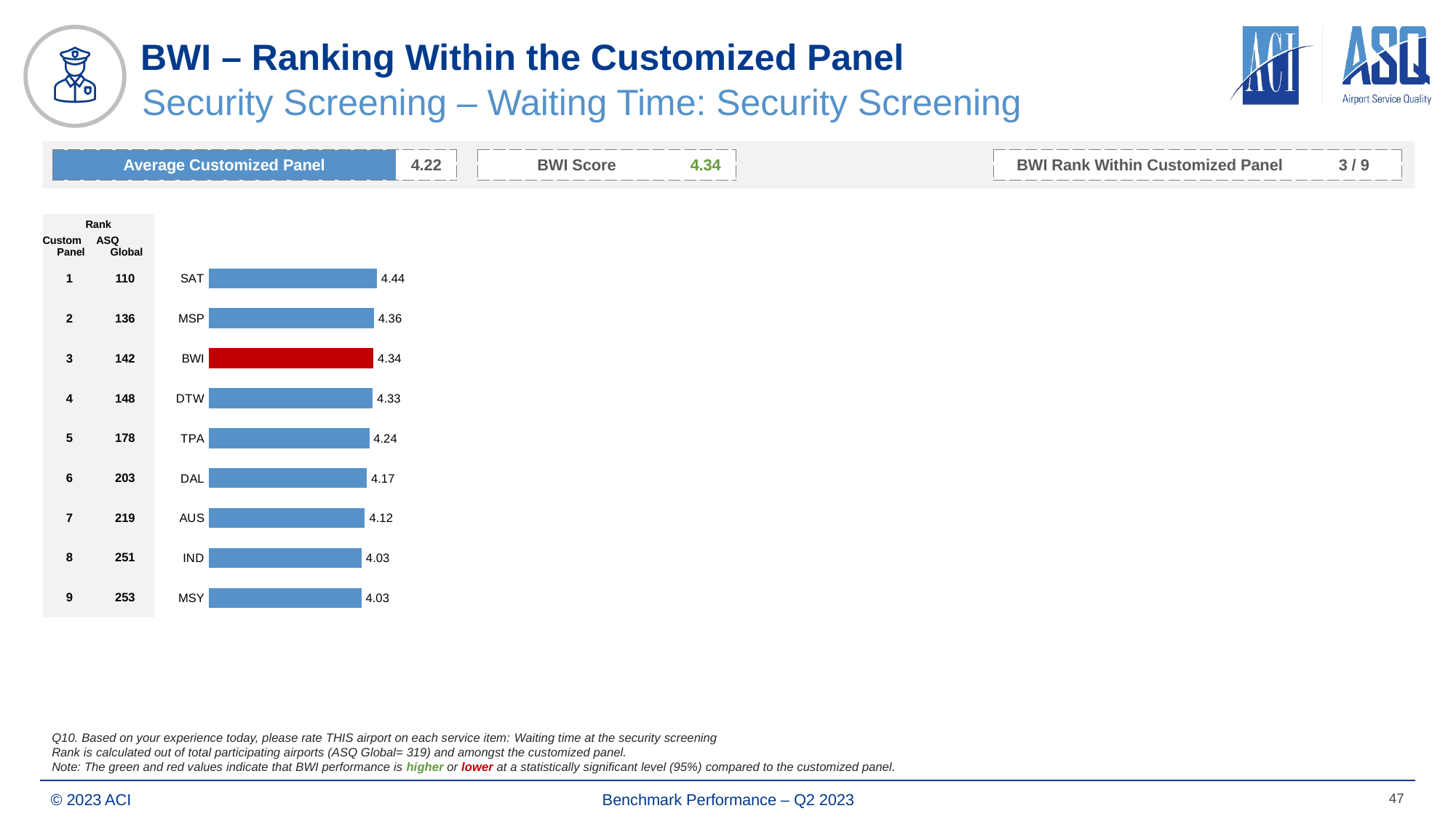
How many airports are shown in the chart? 9 Which airport's bar is coloured red? BWI Do the values rise or fall going down the chart from SAT to MSY? fall Which is larger, the value for MSP or the value for DTW? MSP Which airport has the highest value? SAT What is the value for AUS? 4.12 What kind of chart is shown on the slide? bar chart What is the difference between the values for SAT and MSY? 0.41 What is the value for SAT? 4.44 What is the difference between the values for BWI and DAL? 0.17 What is the value for BWI? 4.34 What is the value for TPA? 4.24